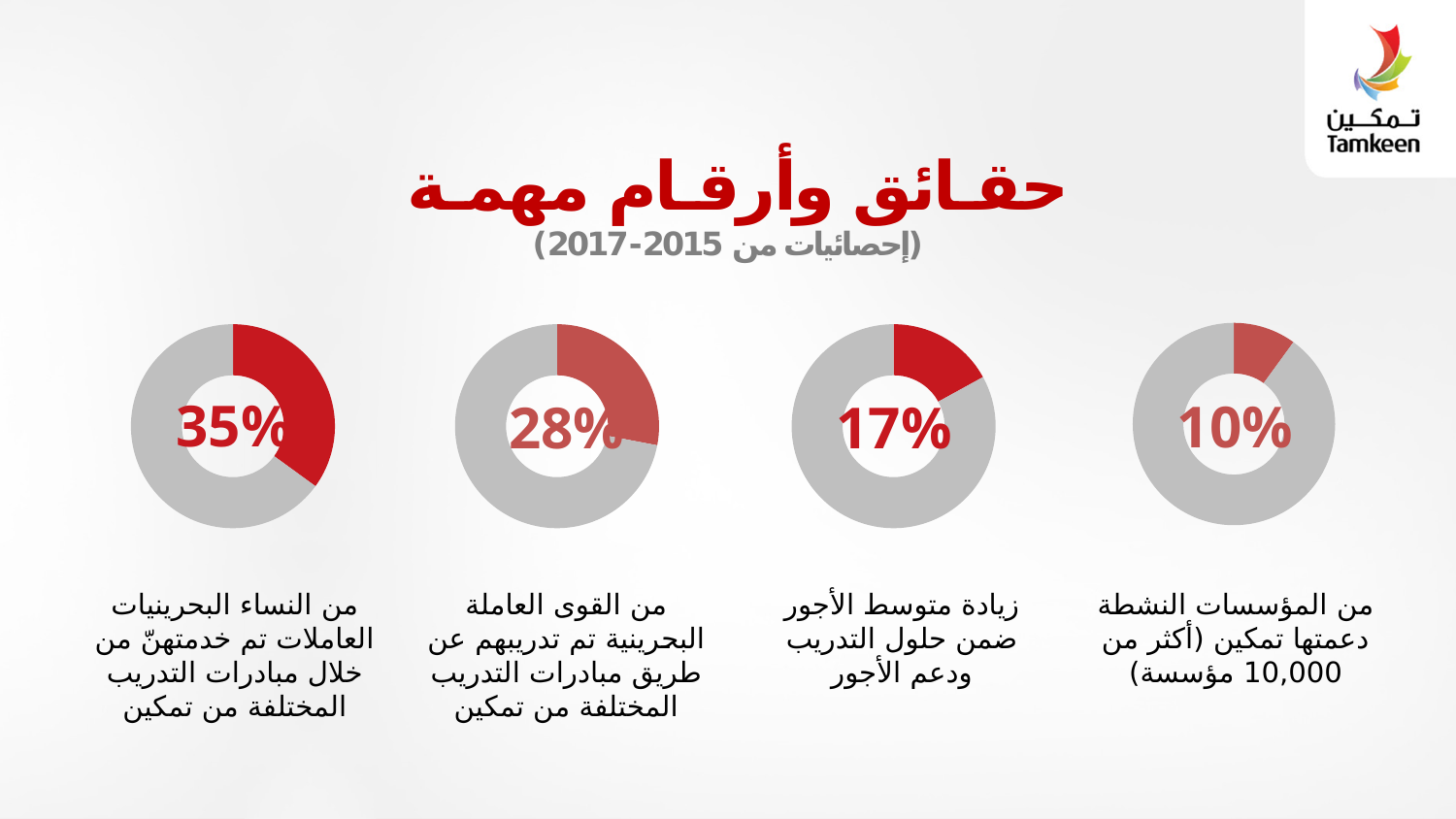
How many donut charts are on the slide? 4 What is the difference between the percentages in the leftmost and rightmost donut charts? 25% What percentage is shown for the increase in average wages within training and wage support solutions (زيادة متوسط الأجور)? 17% Which is larger: the value in the second donut chart from the left or the third donut chart from the left? The second from the left (28%) Which donut chart shows the highest percentage? The leftmost chart (35%) What value is shown in the second donut chart from the left? 28% What type of charts are shown on the slide? Donut (pie) charts What value is shown in the leftmost donut chart? 35% What value is shown in the rightmost donut chart? 10% What value is shown in the third donut chart from the left? 17% Which donut chart shows the lowest percentage? The rightmost chart (10%) What period do the statistics on the slide cover, according to the subtitle? 2015-2017